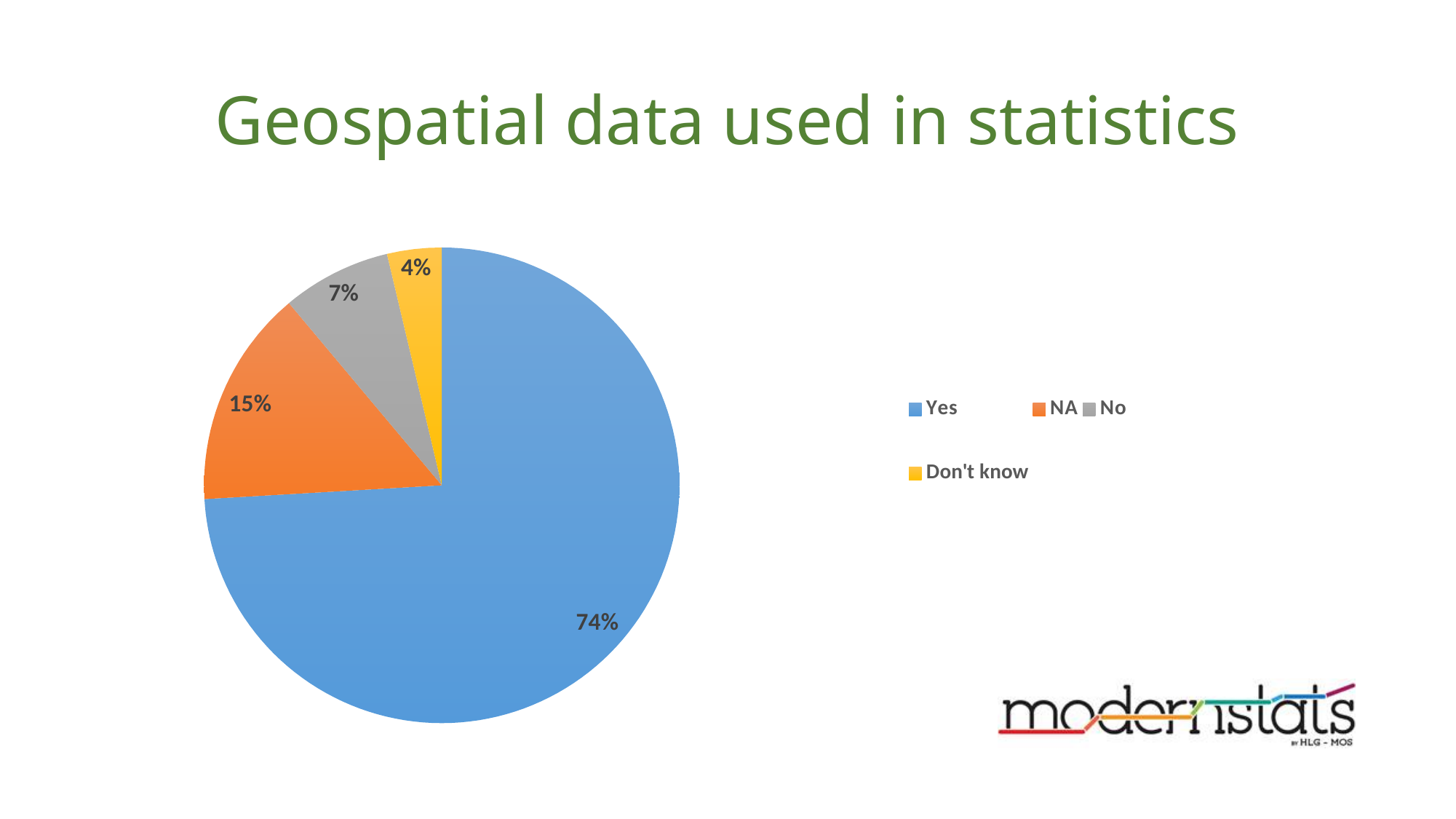
What kind of chart is shown on the slide? Pie chart What percentage of the pie is labelled "NA"? 15% What percentage of the pie is labelled "No"? 7% How many slices does the pie chart have? 4 What is the title of the slide? Geospatial data used in statistics What colour is the "NA" slice? Orange Which slice is larger, "No" or "Don't know"? No What is the difference in percentage points between the "Yes" and "NA" slices? 59 Which category has the largest share of the pie? Yes Which category has the smallest share of the pie? Don't know What percentage of the pie is labelled "Don't know"? 4% What percentage of the pie is labelled "Yes"? 74%